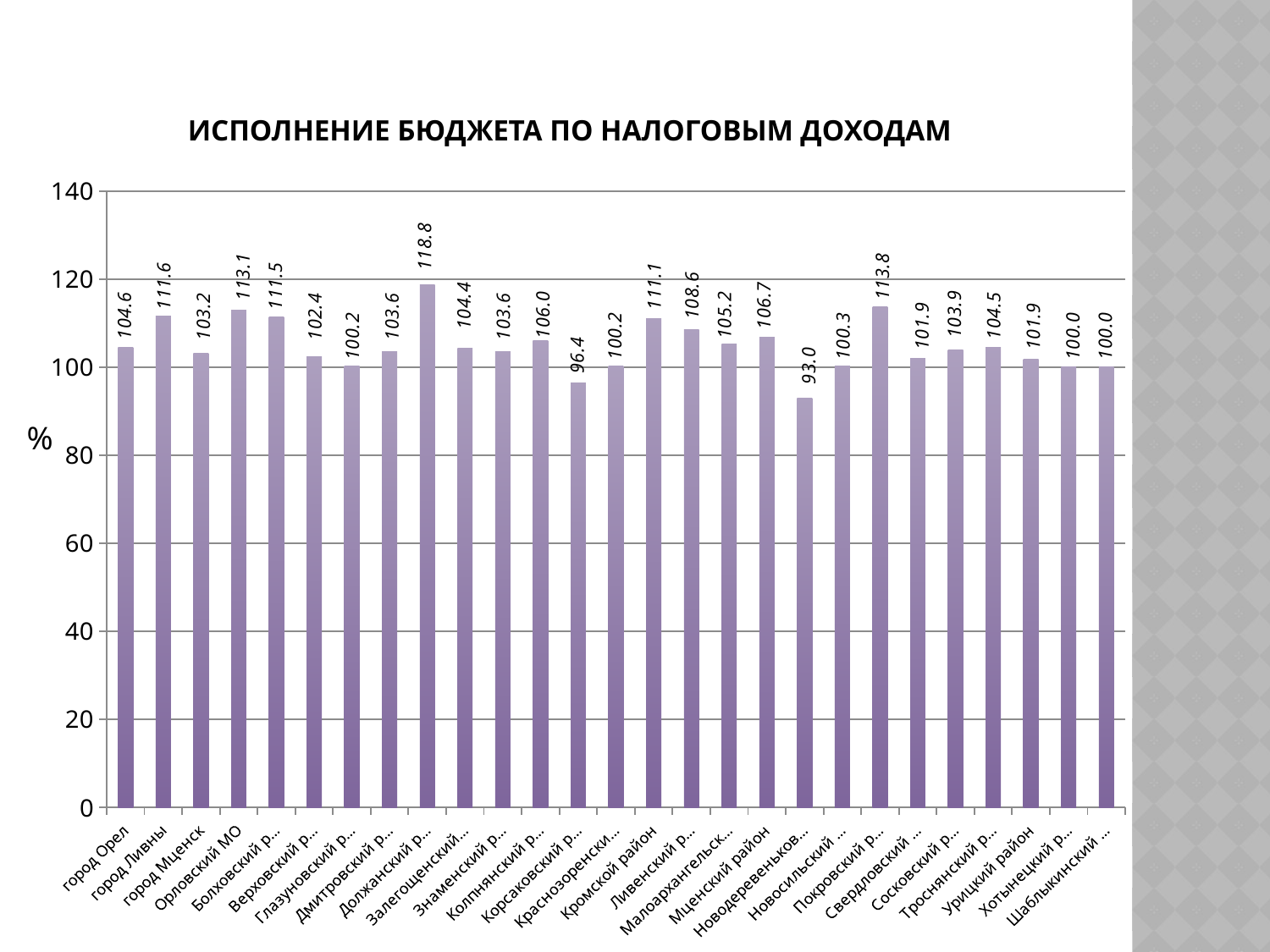
How many categories are plotted in the chart? 27 What is the title of the chart? ИСПОЛНЕНИЕ БЮДЖЕТА ПО НАЛОГОВЫМ ДОХОДАМ What unit label is shown on the vertical axis? % What is the value for Кромской район? 111.1 Which category has the highest value? Должанский р... What type of chart is shown on the slide? bar chart Which is larger, the value for город Орел or the value for Урицкий район? город Орел What is the value for Мценский район? 106.7 What is the difference between the values for город Ливны and город Мценск? 8.4 What is the value for Орловский МО? 113.1 What is the value for город Орел? 104.6 Which category has the lowest value? Новодеревеньков...